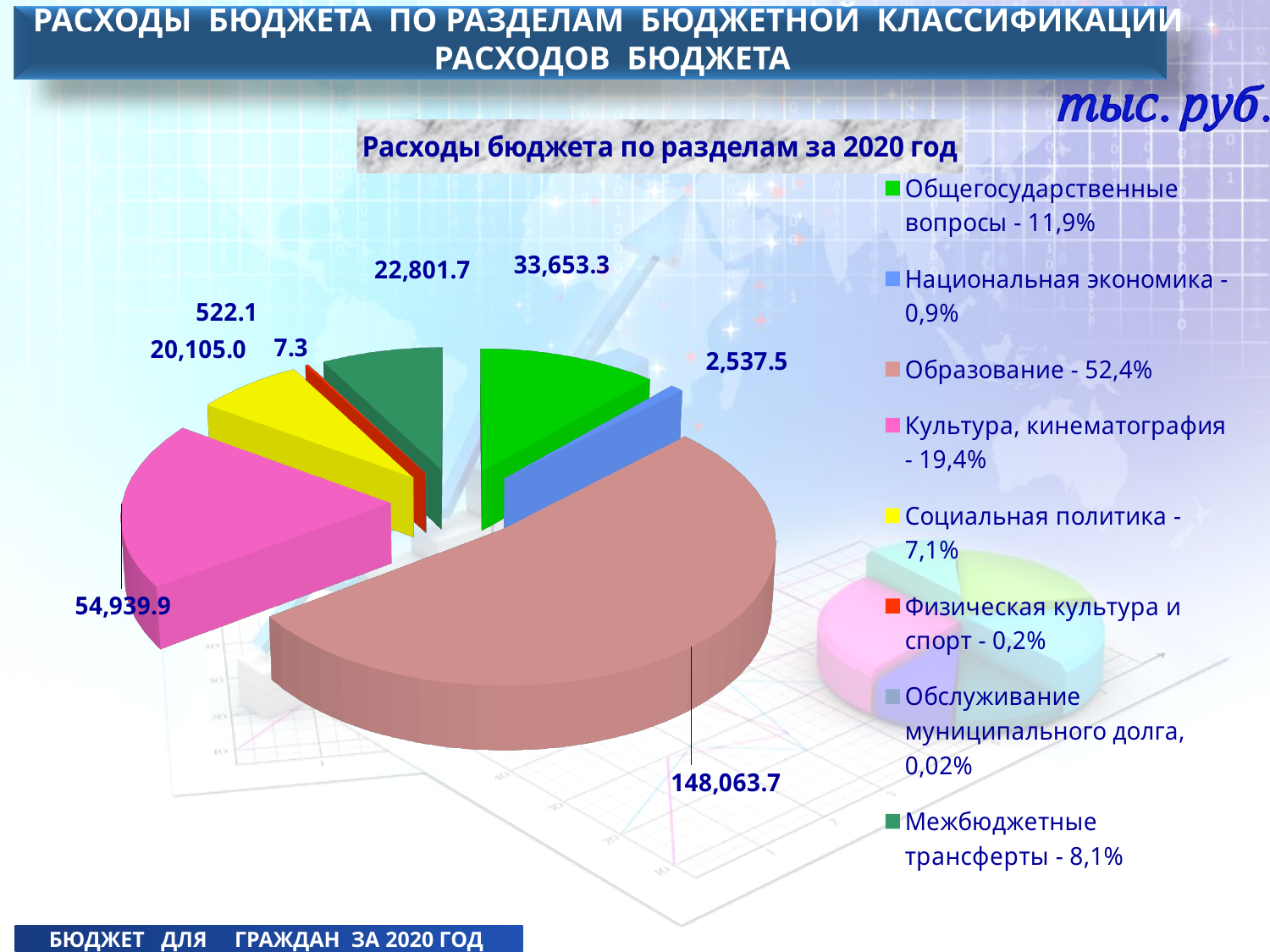
What is the difference between the values for Культура, кинематография and Социальная политика? 34,834.9 What type of chart is shown on the slide? pie chart What is the value for Образование in the pie chart? 148,063.7 Which section has the largest share of the budget expenses? Образование What is the value for Общегосударственные вопросы? 33,653.3 What share of the pie does Образование represent, according to the legend? 52,4% Which section has the smallest value in the pie chart? Обслуживание муниципального долга Which is larger: Межбюджетные трансферты or Социальная политика? Межбюджетные трансферты What is the title of the pie chart? Расходы бюджета по разделам за 2020 год How many sections (slices) does the pie chart show? 8 What is the value for Межбюджетные трансферты? 22,801.7 What is the value for Культура, кинематография? 54,939.9